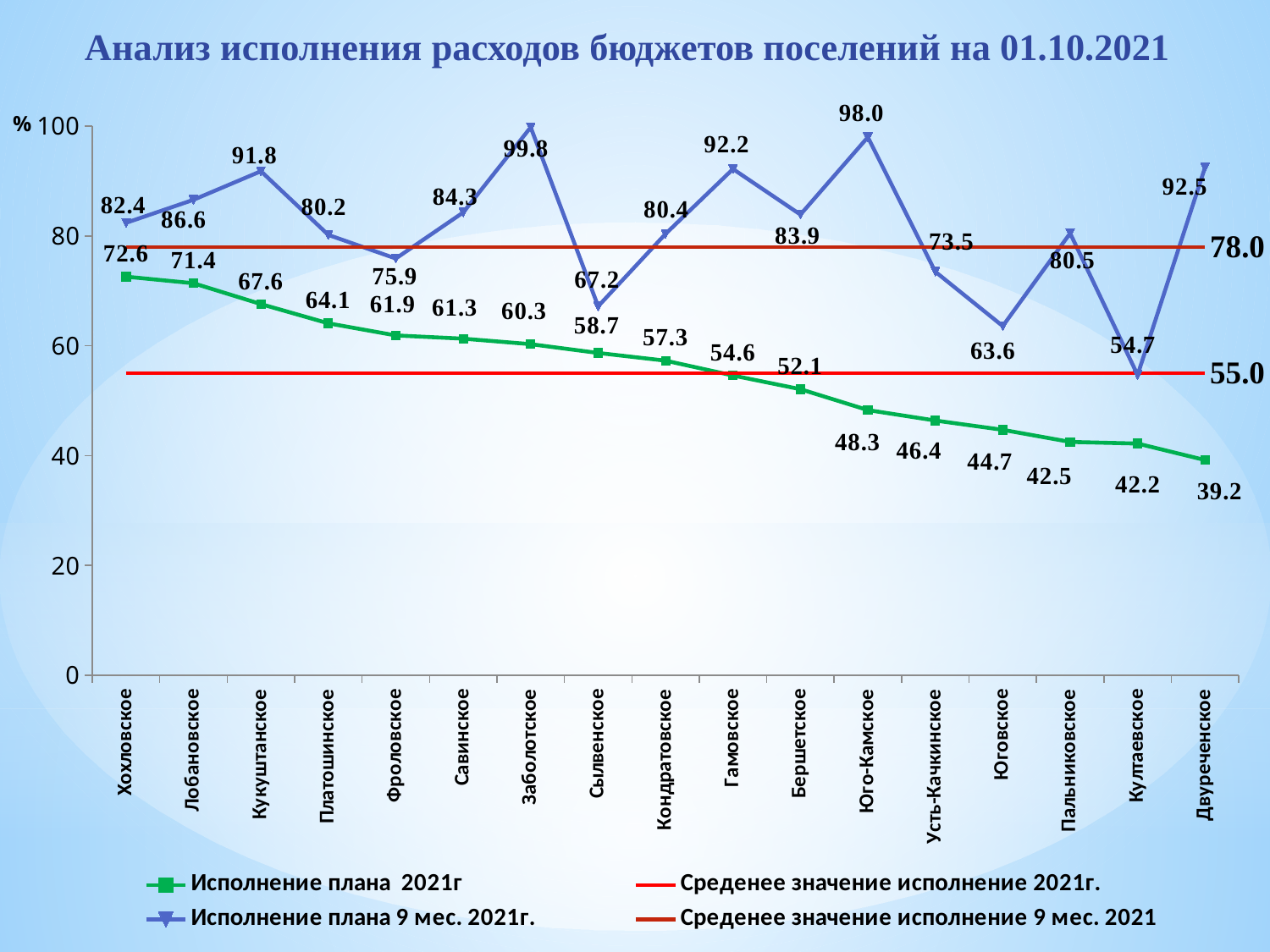
What is the value of the 'Исполнение плана 9 мес. 2021г.' series for Заболотское? 99.8 Does the 'Исполнение плана 2021г' series rise or fall from left to right along the x axis? Fall How many series does the legend list? 4 Which settlement has the highest value in the 'Исполнение плана 9 мес. 2021г.' series? Заболотское Which settlement has the lowest value in the 'Исполнение плана 9 мес. 2021г.' series? Култаевское What kind of chart is shown on the slide? Line chart What is the difference between the 'Исполнение плана 9 мес. 2021г.' value and the 'Исполнение плана 2021г' value for Хохловское? 9.8 What value does the 'Среденее значение исполнение 9 мес. 2021' line show? 78.0 How many settlements are shown on the x axis? 17 Which settlement has the lowest value in the 'Исполнение плана 2021г' series? Двуреченское In the 'Исполнение плана 9 мес. 2021г.' series, which is larger: Юго-Камское or Гамовское? Юго-Камское What is the value of the 'Исполнение плана 2021г' series for Хохловское? 72.6